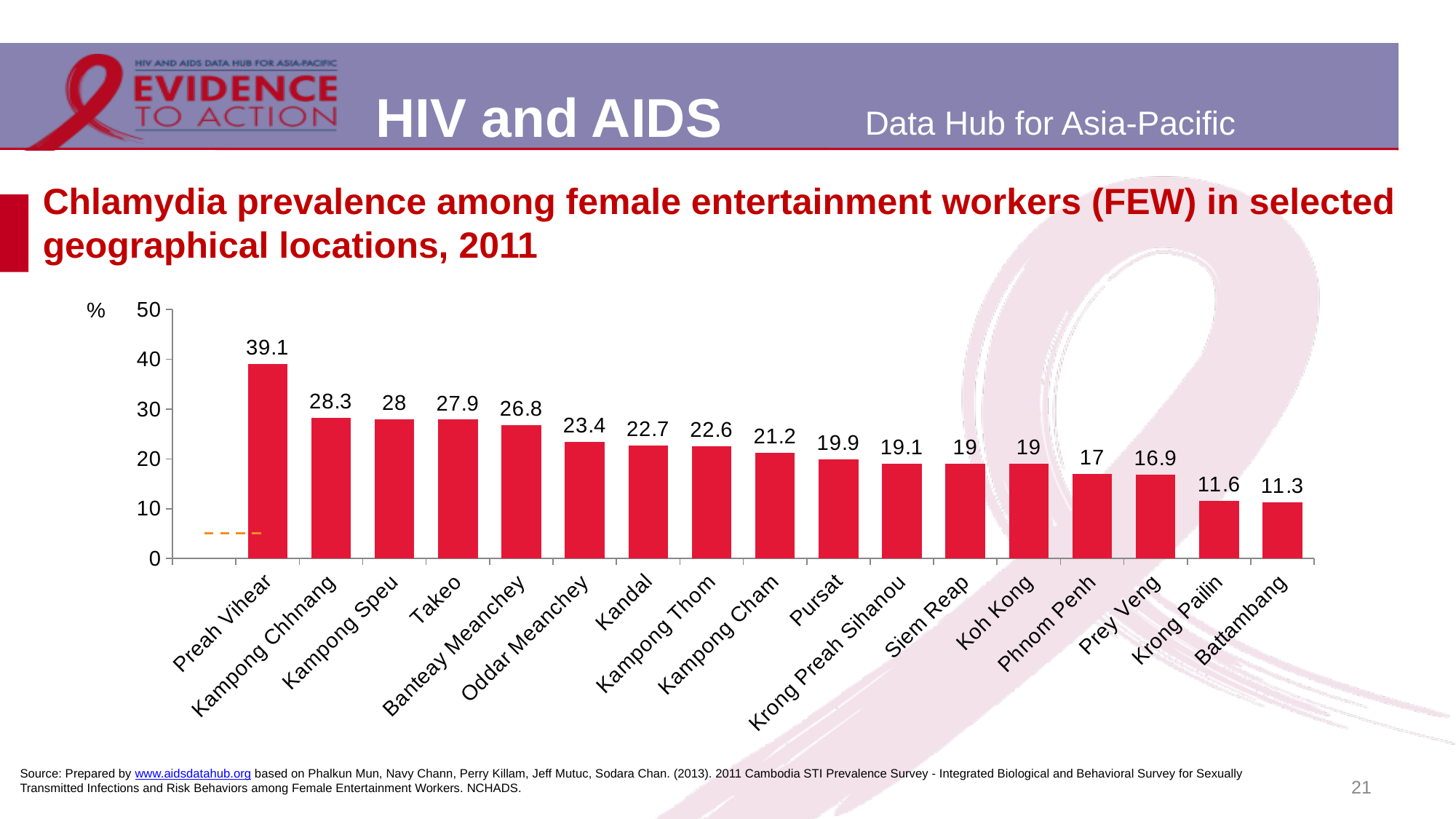
Which has a higher value, Oddar Meanchey or Pursat? Oddar Meanchey Which location has the highest chlamydia prevalence? Preah Vihear What value is shown for Phnom Penh? 17 What kind of chart is used on this slide? Bar chart Is the value for Krong Pailin greater or less than 20? less What is the difference between the values for Preah Vihear and Battambang? 27.8 Which location has the lowest chlamydia prevalence? Battambang What is the difference between the values for Kampong Chhnang and Takeo? 0.4 What value is shown for Kampong Cham? 21.2 What is the chlamydia prevalence value shown for Preah Vihear? 39.1 How many geographical locations are shown in the chart? 17 Do the values generally rise or fall moving from left to right along the x axis? Fall